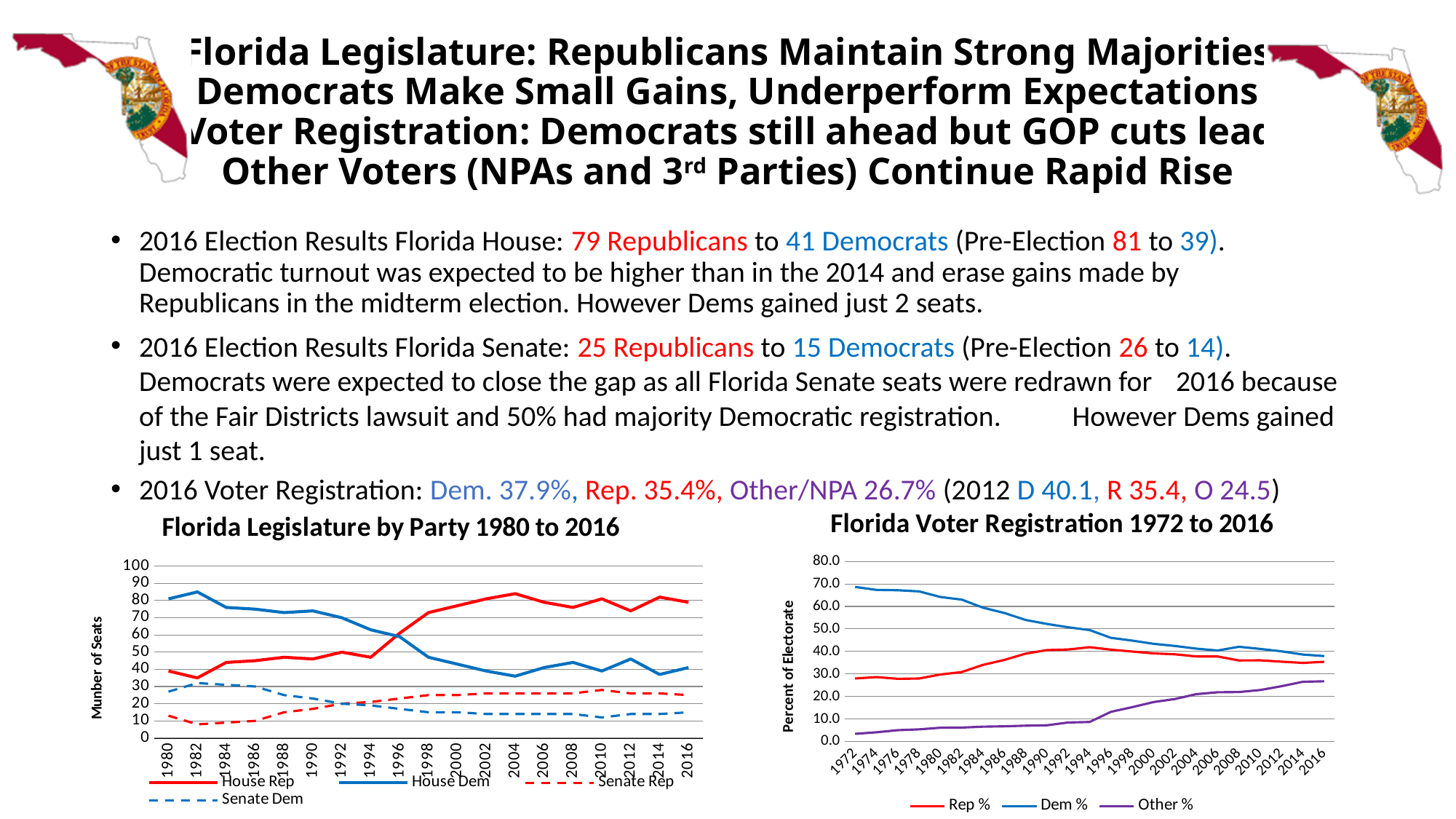
In the 'Florida Voter Registration 1972 to 2016' chart, does the Other % line rise or fall from 1972 to 2016? rise In the 'Florida Legislature by Party 1980 to 2016' chart, which series has the highest value in 2016? House Rep In the 'Florida Voter Registration 1972 to 2016' chart, which is larger in 2016, Dem % or Other %? Dem % In the 'Florida Legislature by Party 1980 to 2016' chart, is the House Rep value for 1980 greater or less than 50? less How many series does the legend of the 'Florida Voter Registration 1972 to 2016' chart list? 3 What type of chart is the 'Florida Legislature by Party 1980 to 2016' chart? line chart In the 'Florida Voter Registration 1972 to 2016' chart, which series has the lowest value in 1972? Other % How many series does the legend of the 'Florida Legislature by Party 1980 to 2016' chart list? 4 In the 'Florida Legislature by Party 1980 to 2016' chart, is the House Dem value for 1982 greater or less than 80? greater In the 'Florida Legislature by Party 1980 to 2016' chart, does the House Dem line rise or fall from 1980 to 2016? fall In the 'Florida Voter Registration 1972 to 2016' chart, is the Dem % value for 1972 greater or less than 60.0? greater In the 'Florida Legislature by Party 1980 to 2016' chart, which is larger in 1980, House Dem or House Rep? House Dem